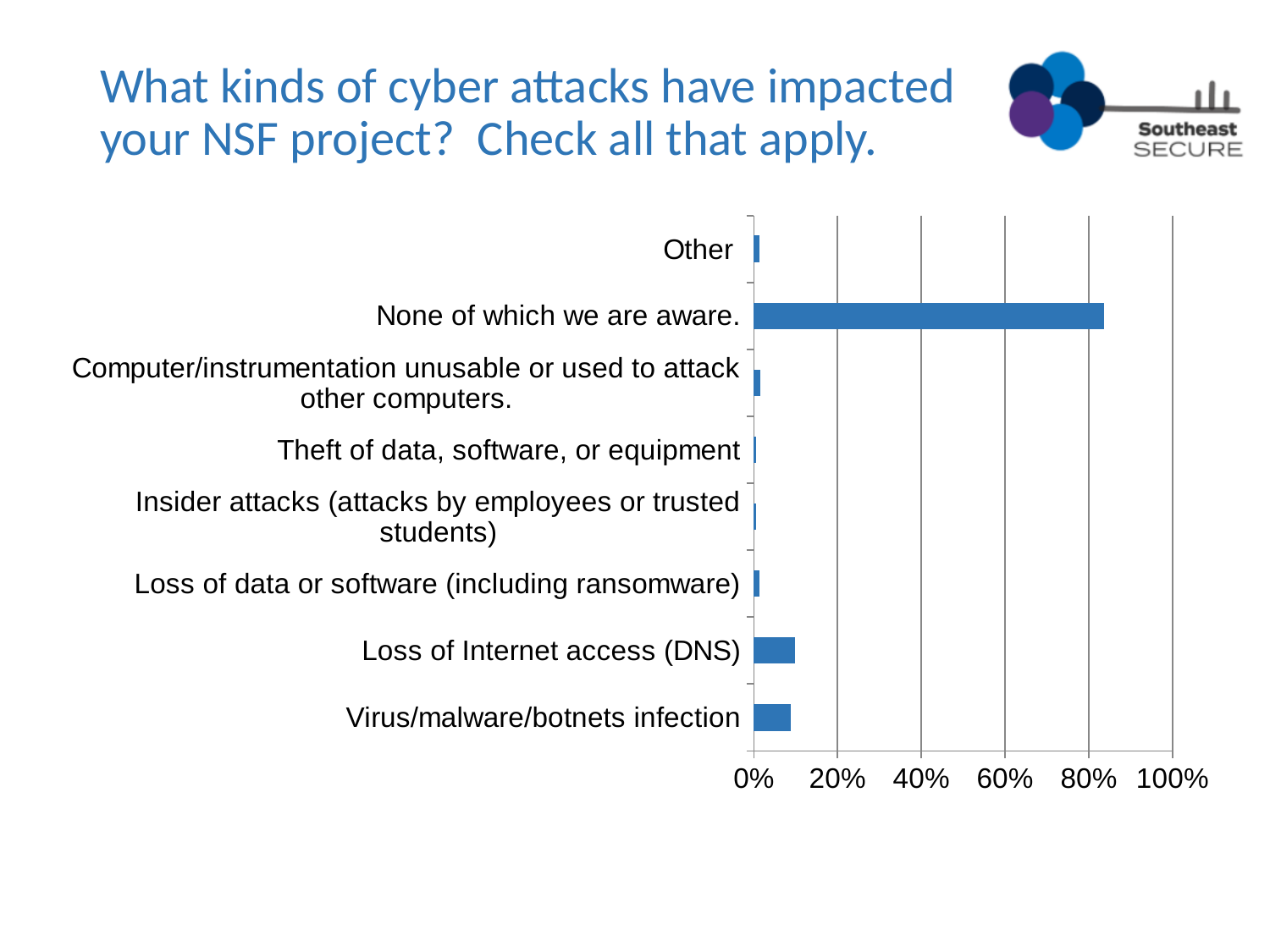
What question does the slide title say the chart answers? What kinds of cyber attacks have impacted your NSF project? Check all that apply. Is the value for "Virus/malware/botnets infection" greater or less than 20%? less How many categories are plotted in the chart? 8 What is the highest value shown on the chart's percentage axis? 100% Which is larger: the value for "None of which we are aware." or the value for "Virus/malware/botnets infection"? None of which we are aware. Is the value for "Other" greater or less than 20%? less Which is larger: the value for "Loss of Internet access (DNS)" or the value for "Other"? Loss of Internet access (DNS) What kind of chart is shown on the slide? bar chart Is the value for "Loss of Internet access (DNS)" greater or less than 20%? less Which is larger: the value for "Virus/malware/botnets infection" or the value for "Theft of data, software, or equipment"? Virus/malware/botnets infection Which category has the highest value in the chart? None of which we are aware.